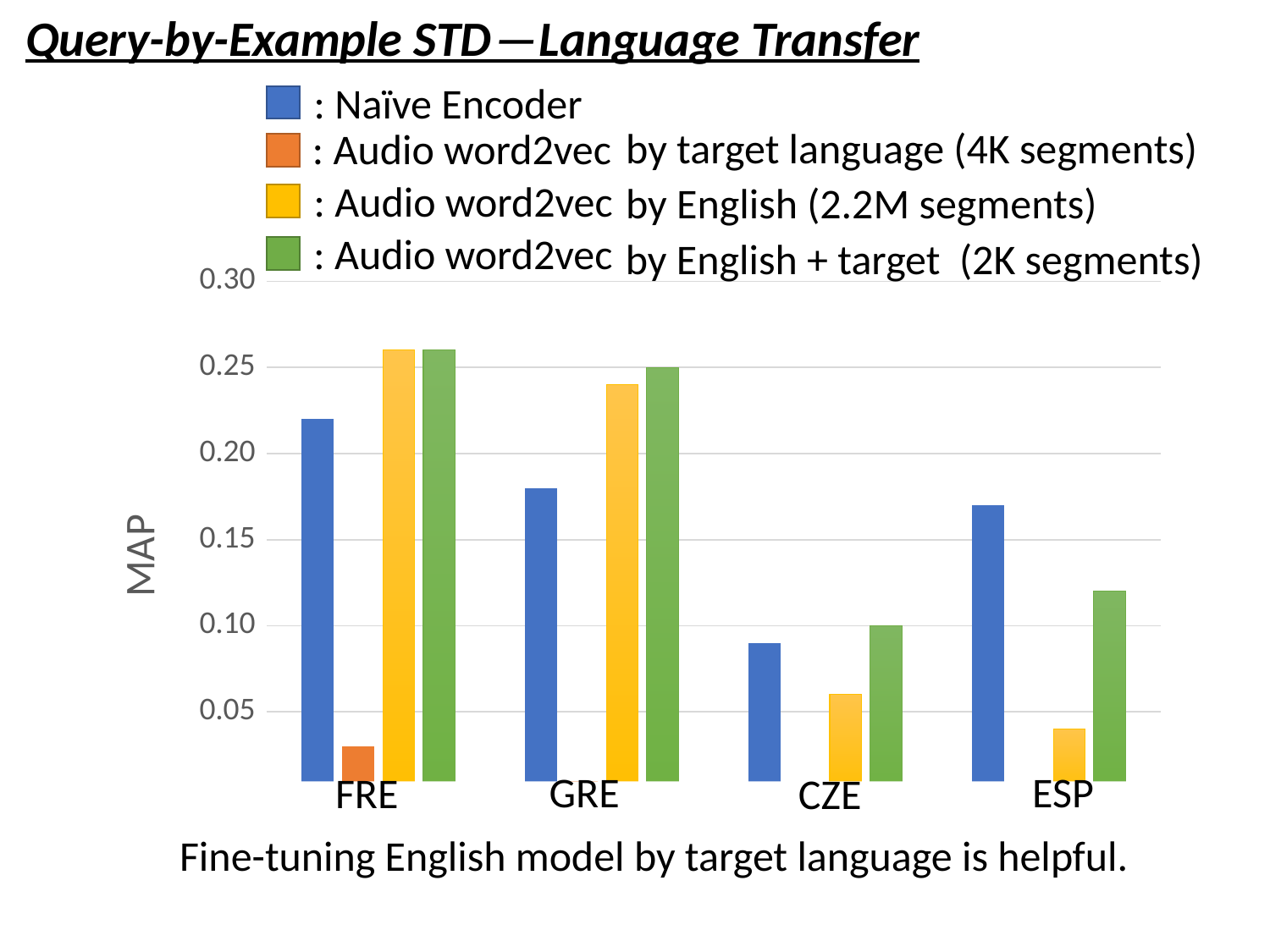
How many language categories are shown on the x axis? 4 For GRE, which is larger: the Naïve Encoder bar or the Audio word2vec by English (2.2M segments) bar? Audio word2vec by English (2.2M segments) Is the Audio word2vec by English + target value for GRE greater or less than 0.20? greater What kind of chart is shown on the slide? bar chart Is the Audio word2vec by English (2.2M segments) value for ESP greater or less than 0.05? less Which language has the lowest Naïve Encoder bar? CZE For ESP, which is larger: the Naïve Encoder bar or the Audio word2vec by English + target bar? Naïve Encoder Is the Naïve Encoder value for FRE greater or less than 0.20? greater How many series does the legend list? 4 What is the label of the y axis? MAP Which language has the highest Naïve Encoder bar? FRE